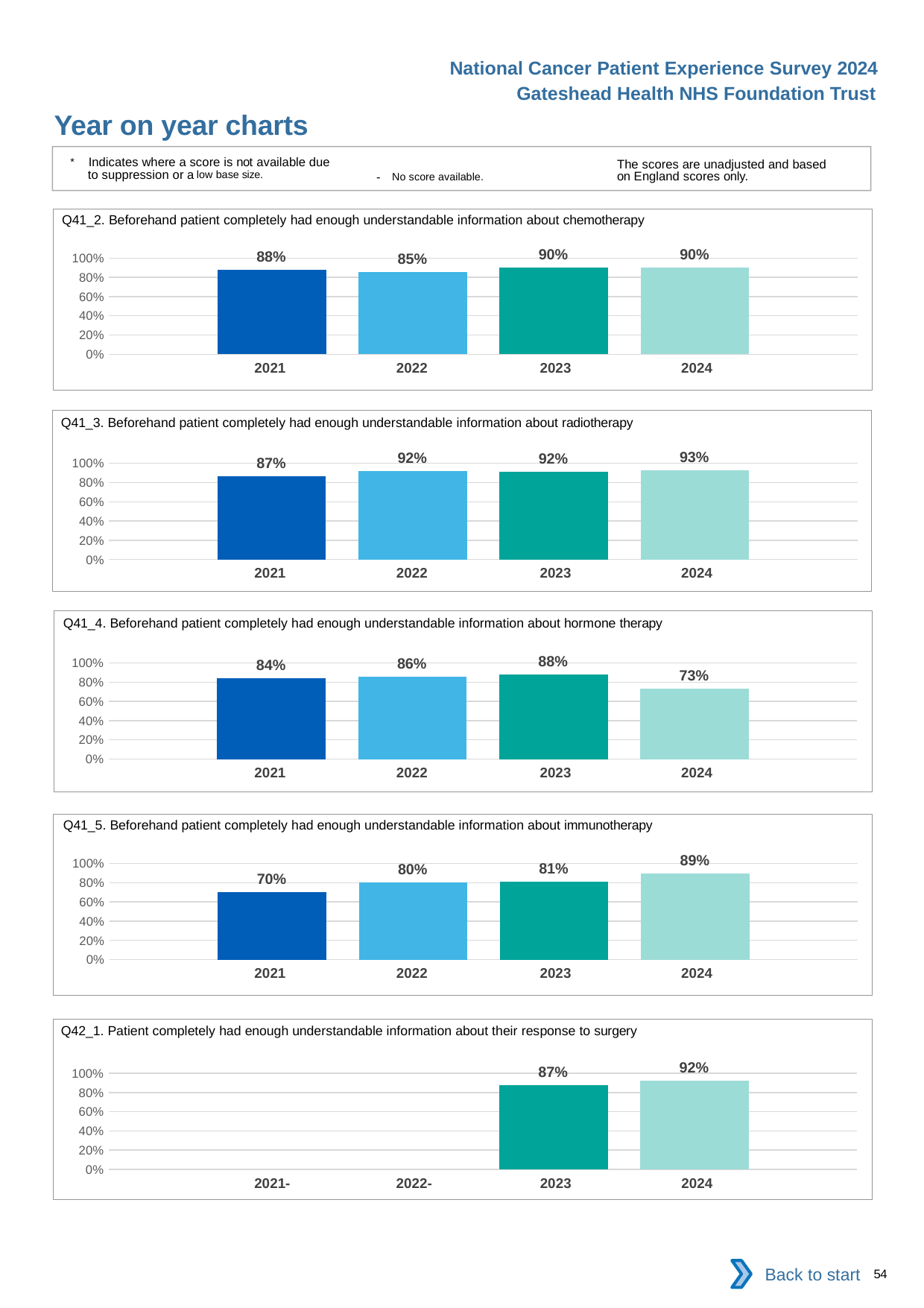
In the Q41_5 chart (immunotherapy), what is the difference between the 2024 and 2021 values? 19% In the Q41_2 chart (chemotherapy), what is the value for 2022? 85% What kind of chart is used for Q41_2 (chemotherapy)? Bar chart In the Q41_5 chart (immunotherapy), do the values rise or fall from 2021 to 2024? Rise How many charts are shown on the slide? 5 In the Q41_4 chart (hormone therapy), what is the value for 2023? 88% In the Q41_3 chart (radiotherapy), what is the difference between the 2022 and 2021 values? 5% In the Q41_2 chart (chemotherapy), which years share the highest value? 2023 and 2024 In the Q41_3 chart (radiotherapy), which year has the highest value? 2024 In the Q41_4 chart (hormone therapy), which year has the lowest value? 2024 How many years have bars plotted in the Q42_1 chart (response to surgery)? 2 In the Q42_1 chart (response to surgery), which is larger, the value for 2023 or 2024? 2024